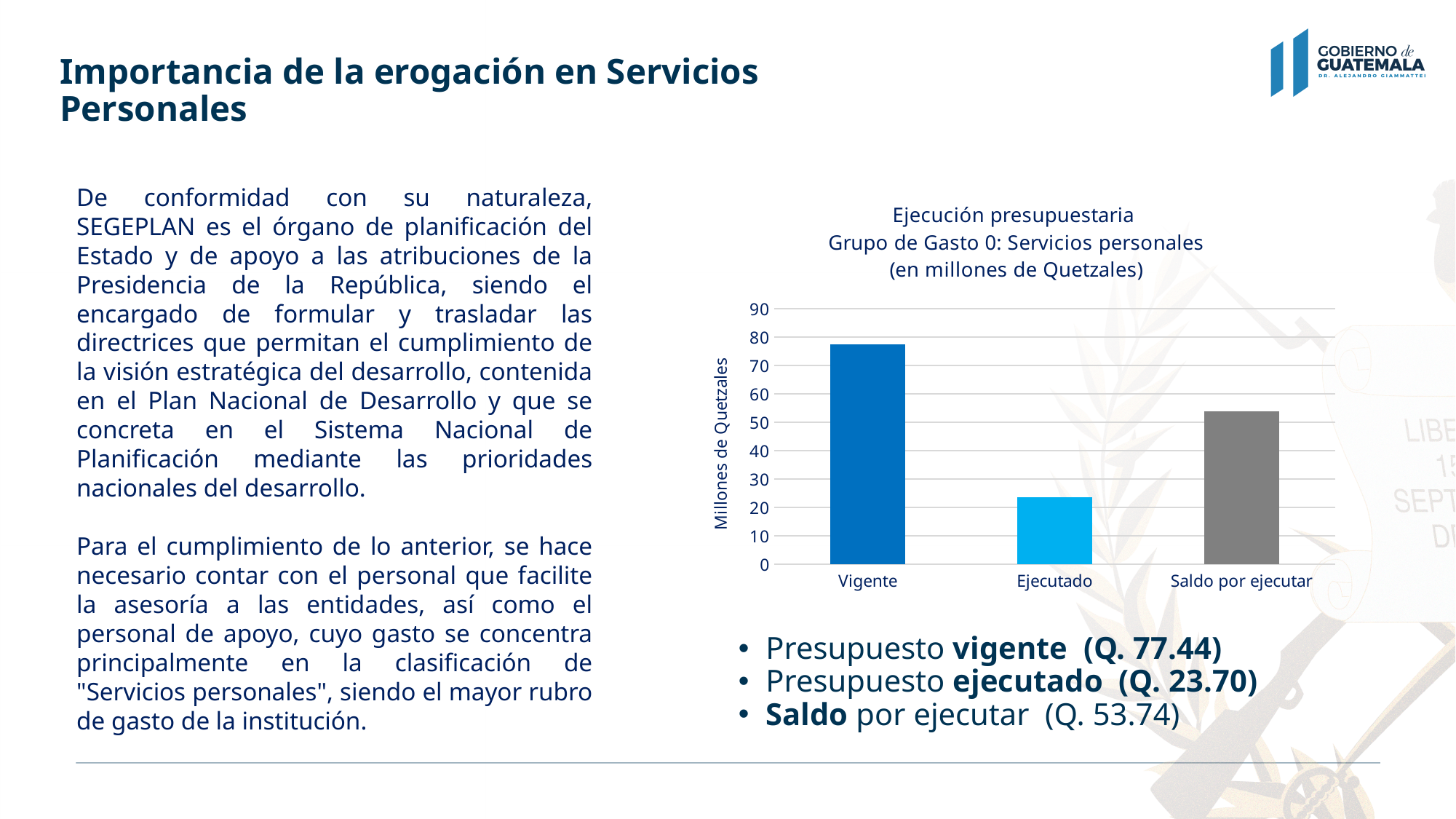
Is the value for Ejecutado greater or less than 30? less Is the value for Saldo por ejecutar greater or less than 50? greater Is the value for Vigente greater or less than 70? greater What type of chart is shown on the slide? bar chart What is the difference between the Presupuesto vigente (Q. 77.44) and the Presupuesto ejecutado (Q. 23.70)? Q. 53.74 Which category has the lowest bar in the chart? Ejecutado How many categories are shown on the x axis of the chart? 3 According to the slide, what is the value of the Presupuesto ejecutado in millions of Quetzales? Q. 23.70 Which is larger, the bar for Saldo por ejecutar or the bar for Ejecutado? Saldo por ejecutar Which category has the highest bar in the chart? Vigente According to the slide, what is the value of the Presupuesto vigente in millions of Quetzales? Q. 77.44 What is the label of the vertical axis of the chart? Millones de Quetzales